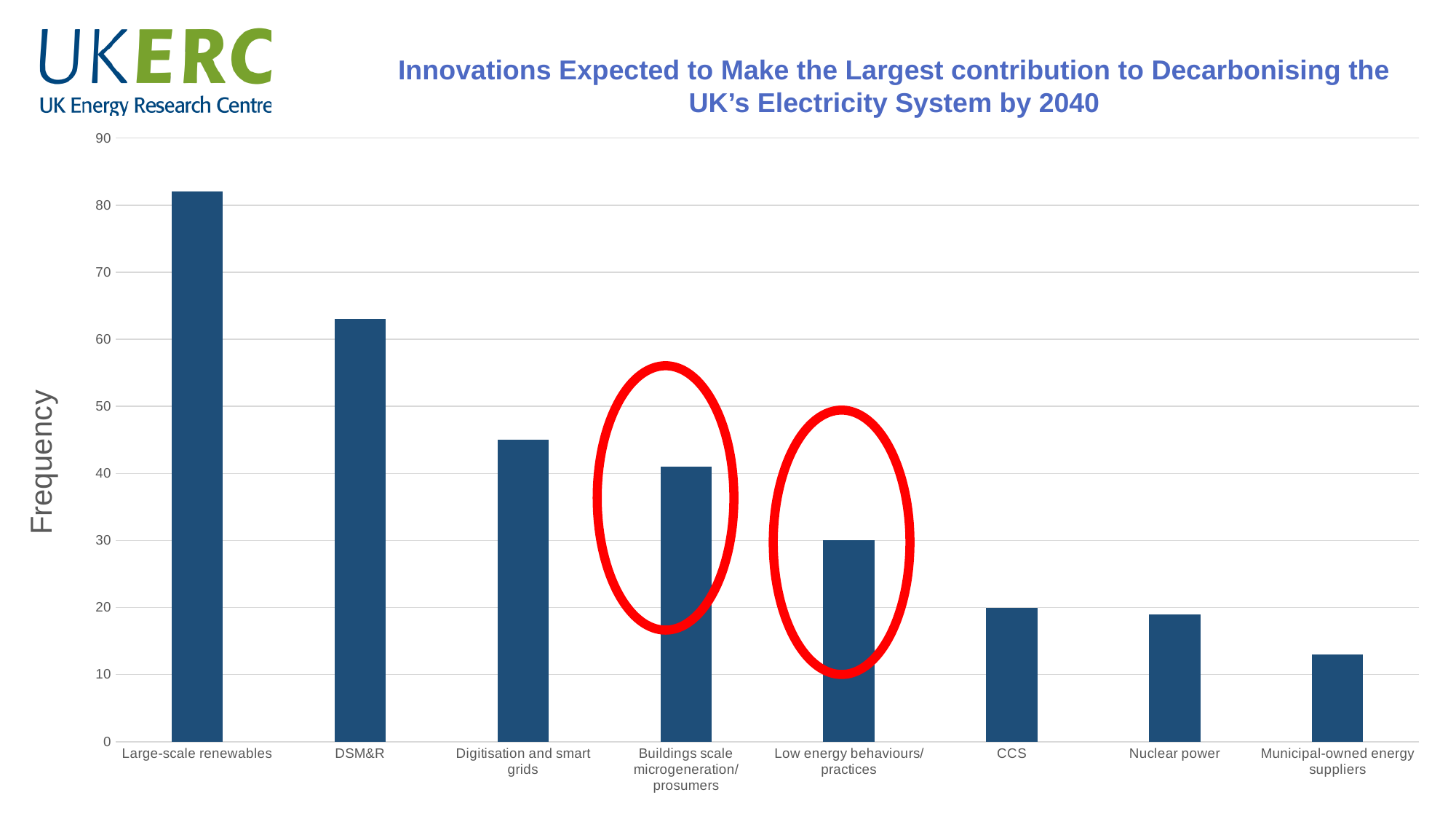
Which category has the highest frequency? Large-scale renewables Is the frequency for Municipal-owned energy suppliers greater or less than 10? greater Do the bar values rise or fall from left to right along the x axis? fall What kind of chart is shown on the slide? bar chart Is the frequency for Digitisation and smart grids greater or less than 50? less Is the frequency for DSM&R greater or less than 60? greater Which category has the lowest frequency? Municipal-owned energy suppliers Which has a higher frequency, DSM&R or Low energy behaviours/practices? DSM&R How many categories are shown on the x axis of the chart? 8 What is the label on the y axis of the chart? Frequency